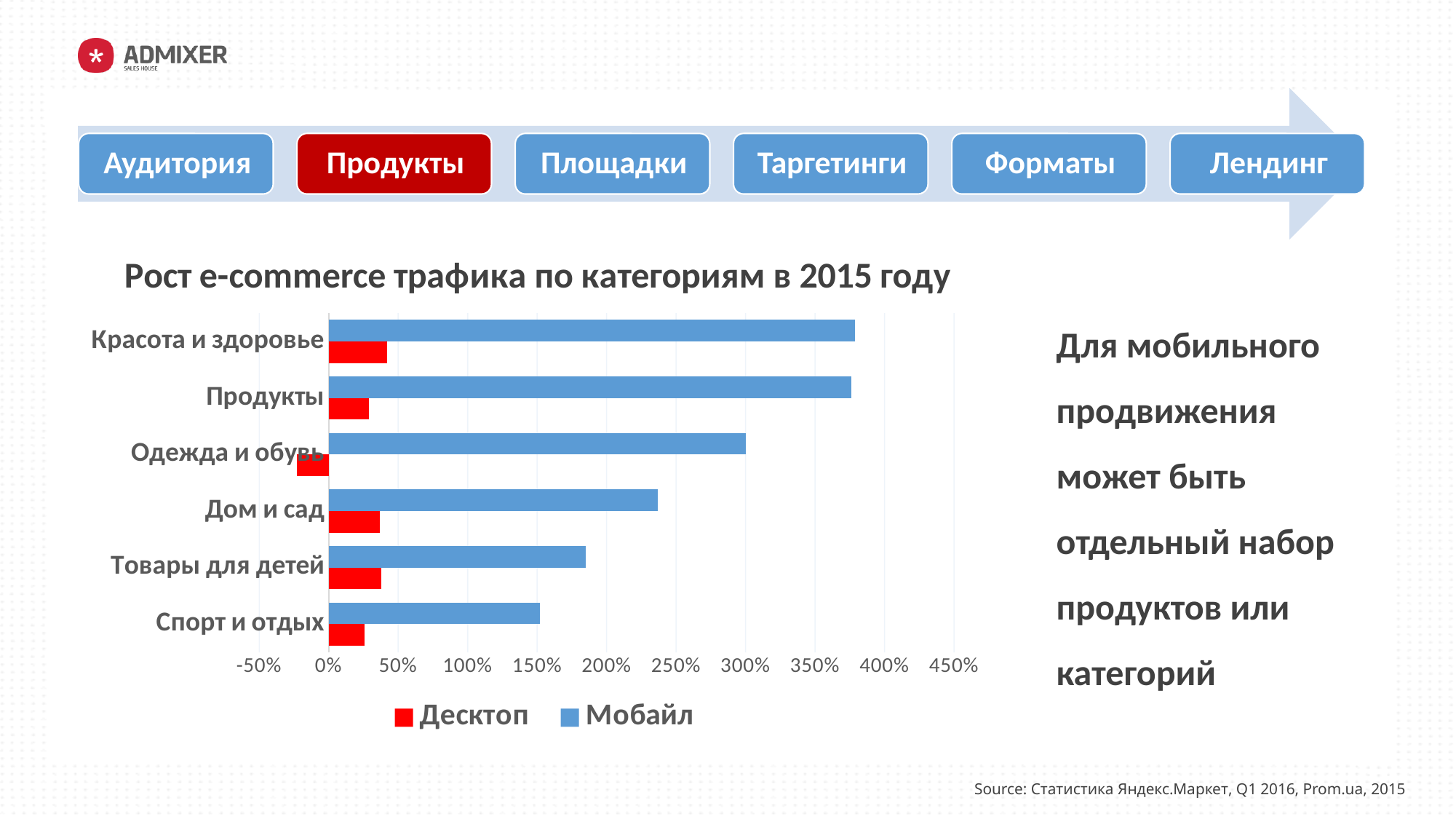
Is the Мобайл value for Спорт и отдых greater or less than 200%? less Which series is shown in red in the legend? Десктоп Is the Мобайл value for Одежда и обувь greater or less than 250%? greater Which category has the larger Мобайл value: Одежда и обувь or Дом и сад? Одежда и обувь Which is larger for Продукты: the Мобайл value or the Десктоп value? Мобайл Which category has the lowest Десктоп value? Одежда и обувь What kind of chart is shown on the slide? bar chart How many series does the legend list? 2 Is the Десктоп value for Одежда и обувь greater or less than 0%? less What is the title of the chart? Рост e-commerce трафика по категориям в 2015 году How many categories are shown on the chart? 6 Which category has the lowest Мобайл value? Спорт и отдых